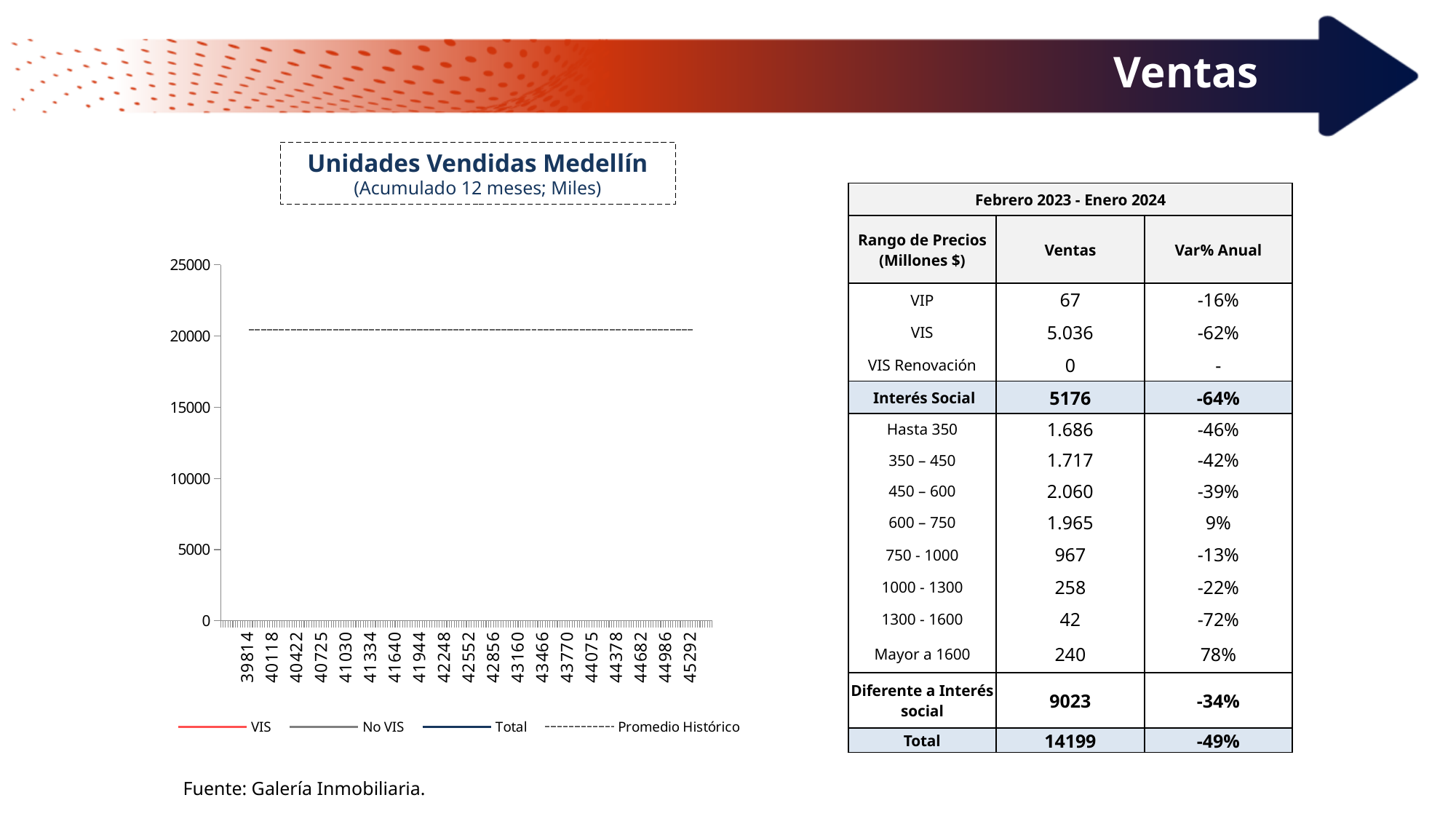
In the 'Unidades Vendidas Medellín' chart, is the Promedio Histórico line greater or less than 20000? greater In the 'Unidades Vendidas Medellín' chart, is the Promedio Histórico line greater or less than 25000? less In the 'Unidades Vendidas Medellín' chart, does the Promedio Histórico line rise, fall, or stay flat along the x axis? stays flat What kind of chart is 'Unidades Vendidas Medellín'? line chart What is the highest value shown on the y axis of the 'Unidades Vendidas Medellín' chart? 25000 Which series in the 'Unidades Vendidas Medellín' chart is drawn with a dashed line? Promedio Histórico How many series does the legend of the 'Unidades Vendidas Medellín' chart list? 4